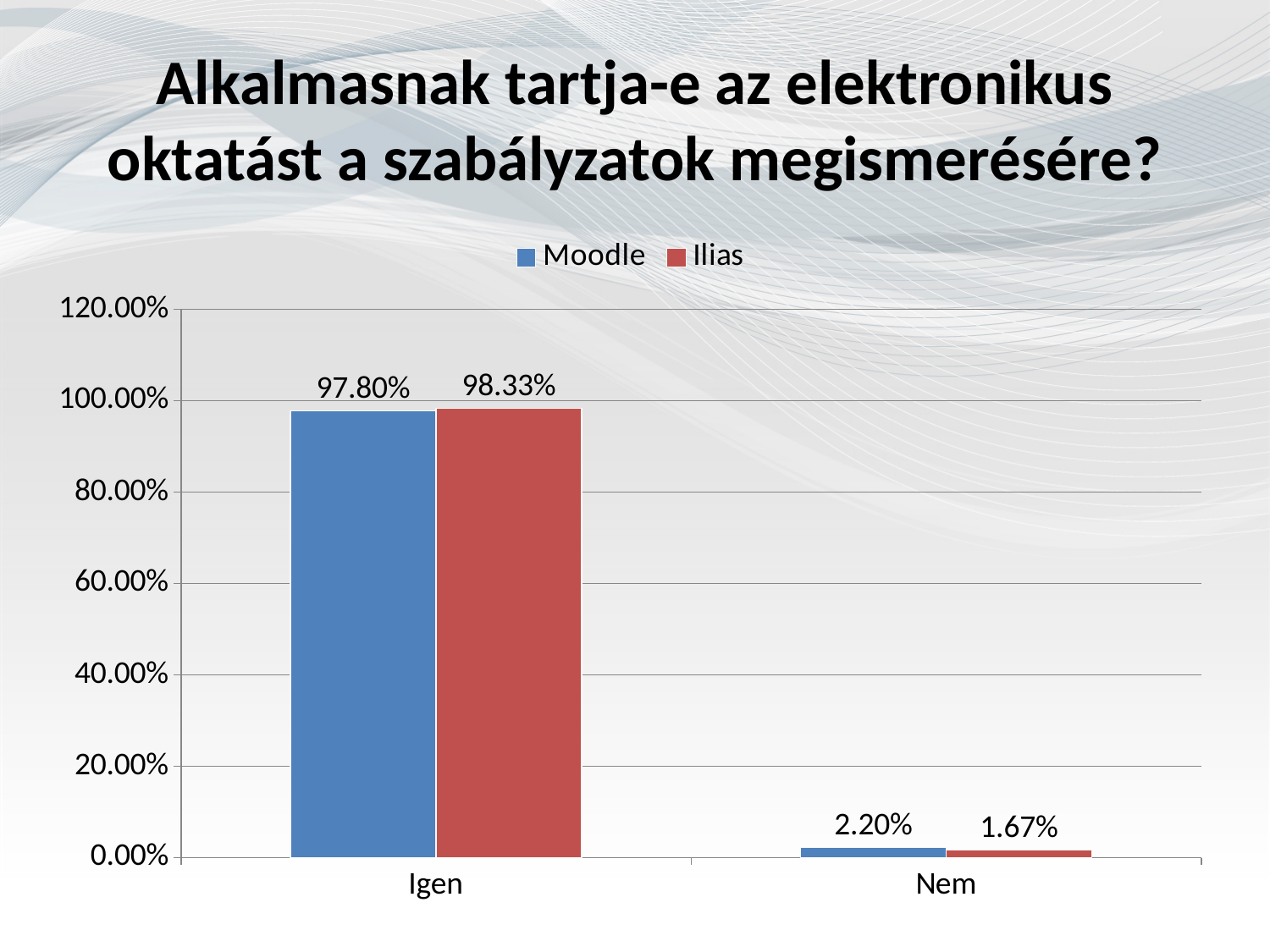
What is the value for Ilias in the Igen category? 98.33% What is the value for Moodle in the Nem category? 2.20% Is the Moodle value for Igen greater or less than 80.00%? greater How many series does the legend list? 2 How many categories are shown on the x axis? 2 What is the difference between the Ilias and Moodle values in the Igen category? 0.53% What is the difference between the Moodle values for Igen and Nem? 95.60% What is the value for Moodle in the Igen category? 97.80% What is the value for Ilias in the Nem category? 1.67% Which category has the highest value for the Moodle series? Igen What kind of chart is shown on the slide? bar chart Which category has the lowest value for the Ilias series? Nem